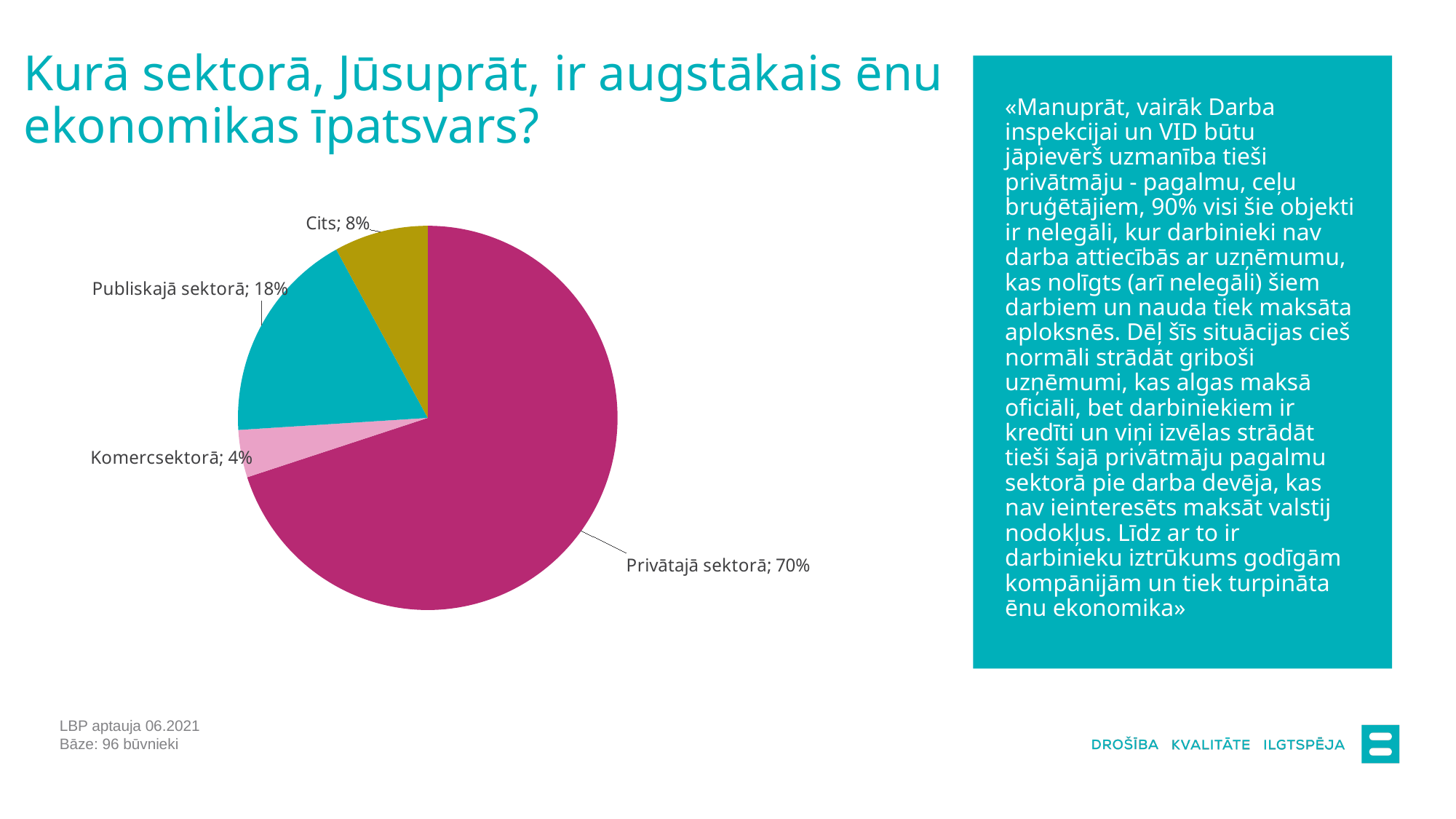
What colour is the slice for Privātajā sektorā? Magenta What is the value for Cits? 8% How many categories are shown in the pie chart? 4 Which is larger, the value for Publiskajā sektorā or the value for Cits? Publiskajā sektorā Which category has the smallest slice of the pie? Komercsektorā What kind of chart is shown on the slide? Pie chart What is the difference between the values for Cits and Komercsektorā? 4% Which category has the largest slice of the pie? Privātajā sektorā What share of the pie does Privātajā sektorā have? 70% What is the difference between the values for Privātajā sektorā and Publiskajā sektorā? 52% What is the value for Publiskajā sektorā? 18% What is the value for Komercsektorā? 4%